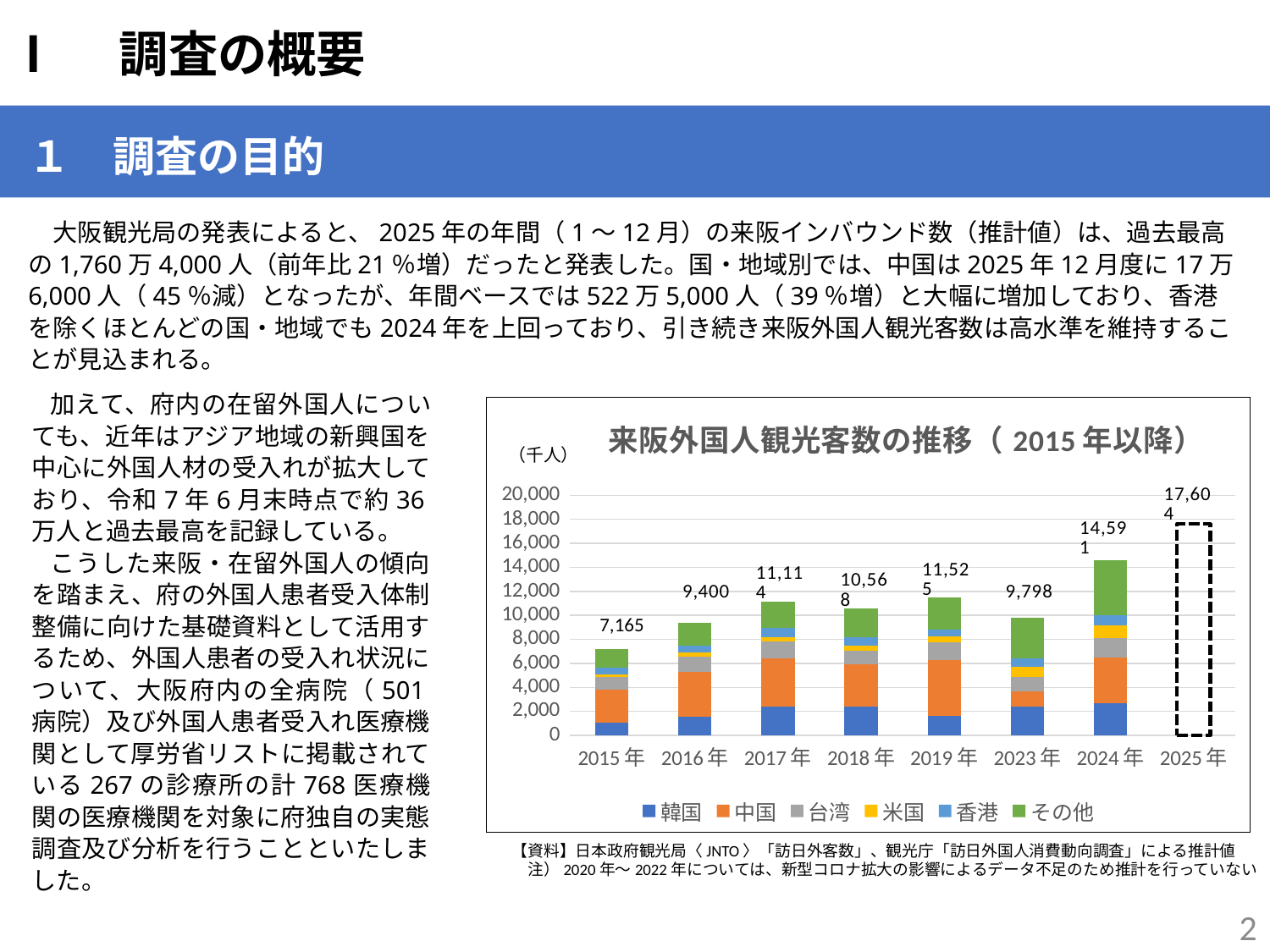
What is the total value labeled for 2025年? 17,604 Which year has the highest total value? 2025年 Do the total values rise or fall from 2023年 to 2025年? Rise What is the total value labeled for 2024年? 14,591 Which is larger, the total for 2017年 or the total for 2018年? 2017年 Which year has the lowest total value? 2015年 What kind of chart is shown on the slide? Stacked bar chart What is the title of the chart? 来阪外国人観光客数の推移（2015年以降） How many series does the chart's legend list? 6 What is the difference between the total for 2025年 and the total for 2024年? 3,013 How many years (categories) are plotted on the x axis? 8 What is the total value labeled for 2015年? 7,165